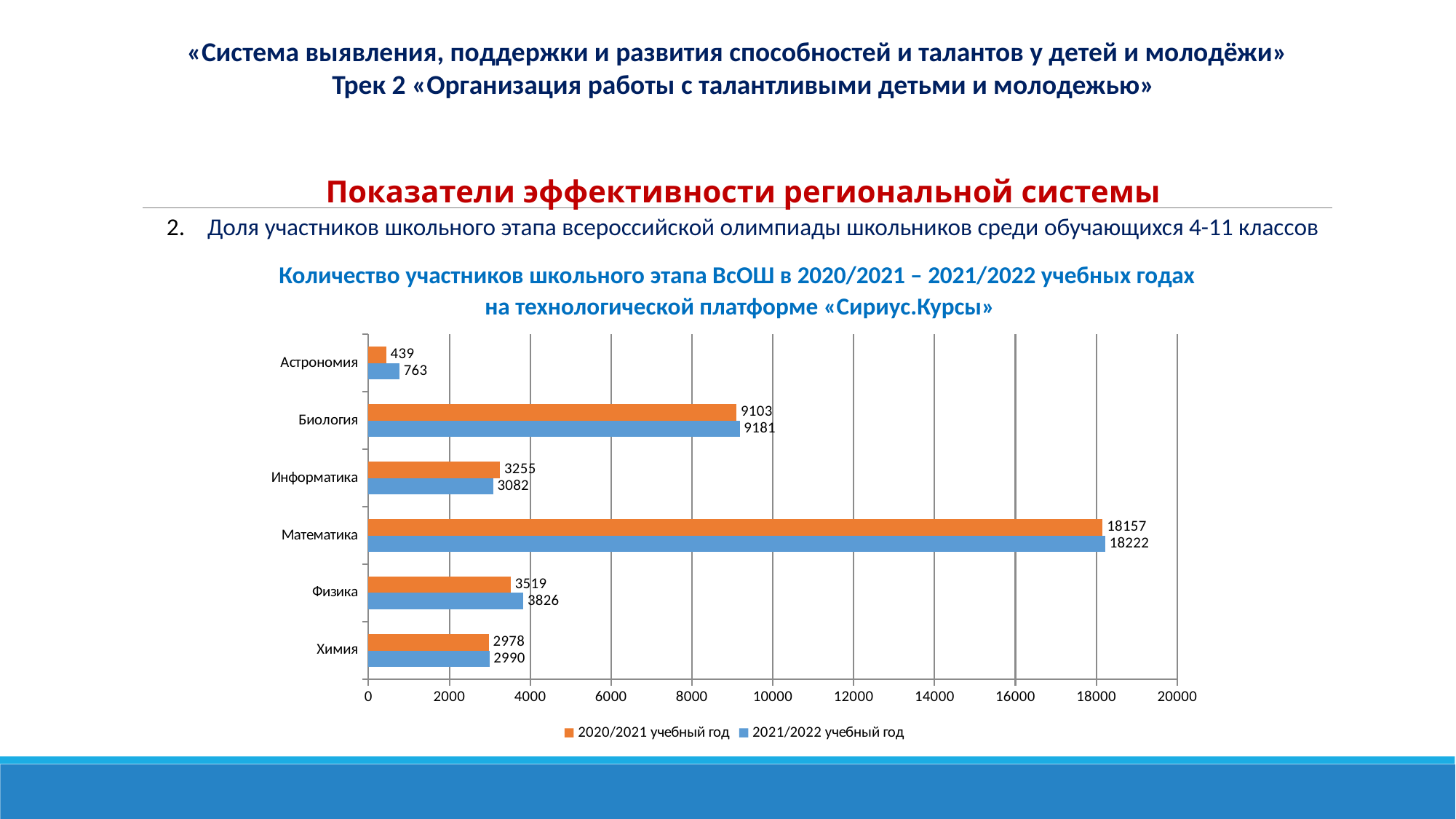
Is the value for Биология in the 2021/2022 учебный год series greater or less than 8000? greater Which is larger for Физика: the 2020/2021 учебный год value or the 2021/2022 учебный год value? 2021/2022 учебный год What kind of chart is shown on the slide? bar chart How many series does the legend list? 2 How many categories (subjects) are shown on the chart? 6 What is the value for Математика in the 2021/2022 учебный год series? 18222 What is the value for Физика in the 2021/2022 учебный год series? 3826 What is the value for Астрономия in the 2020/2021 учебный год series? 439 Which category has the highest value in the 2020/2021 учебный год series? Математика What is the difference between the 2020/2021 and 2021/2022 values for Информатика? 173 Which category has the lowest value in the 2021/2022 учебный год series? Астрономия What is the difference between the 2021/2022 and 2020/2021 values for Астрономия? 324